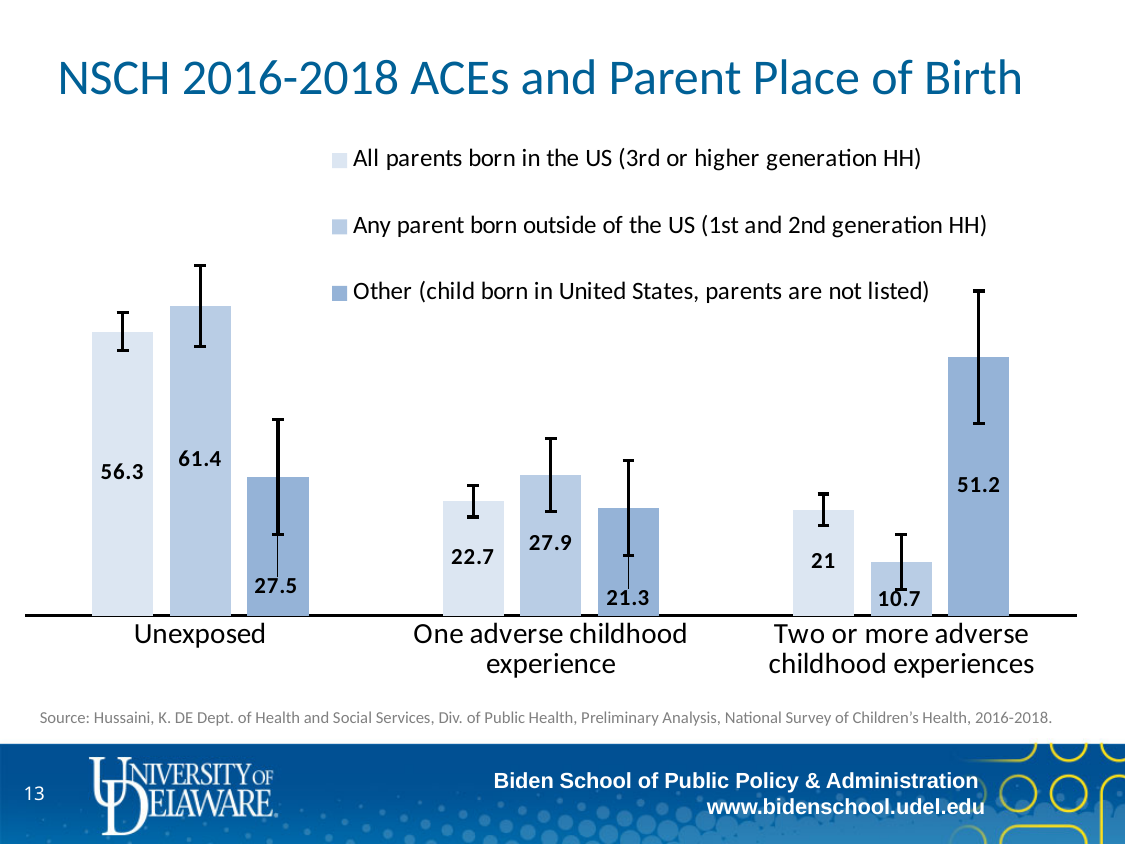
In the 'One adverse childhood experience' category, which is larger: the 'Any parent born outside of the US' value or the 'Other' value? Any parent born outside of the US What is the difference between the 'Any parent born outside of the US' value and the 'All parents born in the US' value in the Unexposed category? 5.1 Which series has the lowest value in the 'Two or more adverse childhood experiences' category? Any parent born outside of the US (1st and 2nd generation HH) What is the value for 'Other (child born in United States, parents are not listed)' in the 'Two or more adverse childhood experiences' category? 51.2 What is the value for 'Any parent born outside of the US (1st and 2nd generation HH)' in the Unexposed category? 61.4 Which series has the highest value in the Unexposed category? Any parent born outside of the US (1st and 2nd generation HH) What is the difference between the 'Other' value and the 'Any parent born outside of the US' value in the 'Two or more adverse childhood experiences' category? 40.5 What is the title of the slide? NSCH 2016-2018 ACEs and Parent Place of Birth What is the value for 'All parents born in the US (3rd or higher generation HH)' in the 'One adverse childhood experience' category? 22.7 How many categories are shown on the x axis? 3 What kind of chart is shown on the slide? Bar chart How many series does the legend list? 3